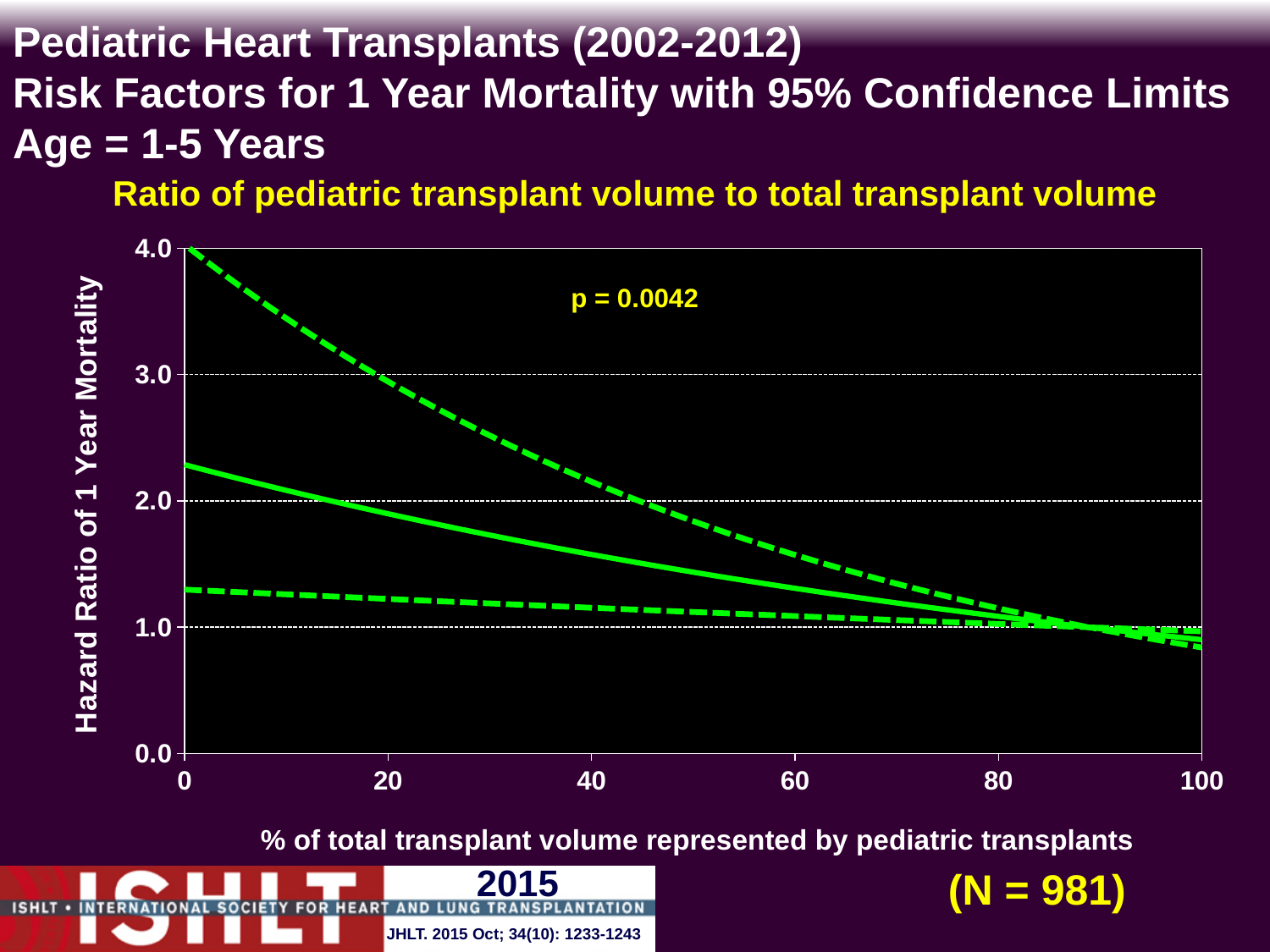
Is the lower dashed confidence limit at 0% greater or less than 1.0? greater Is the upper dashed confidence limit at 0% greater or less than 3.0? greater What kind of chart is shown on the slide? line chart Does the solid hazard ratio line rise or fall as the % of total transplant volume represented by pediatric transplants increases? fall Does the upper dashed confidence limit rise or fall along the x axis? fall Is the hazard ratio on the solid line at 60% greater or less than 2.0? less What p-value is shown on the chart? p = 0.0042 What is the sample size (N) shown on the slide? N = 981 How many lines are plotted on the chart? 3